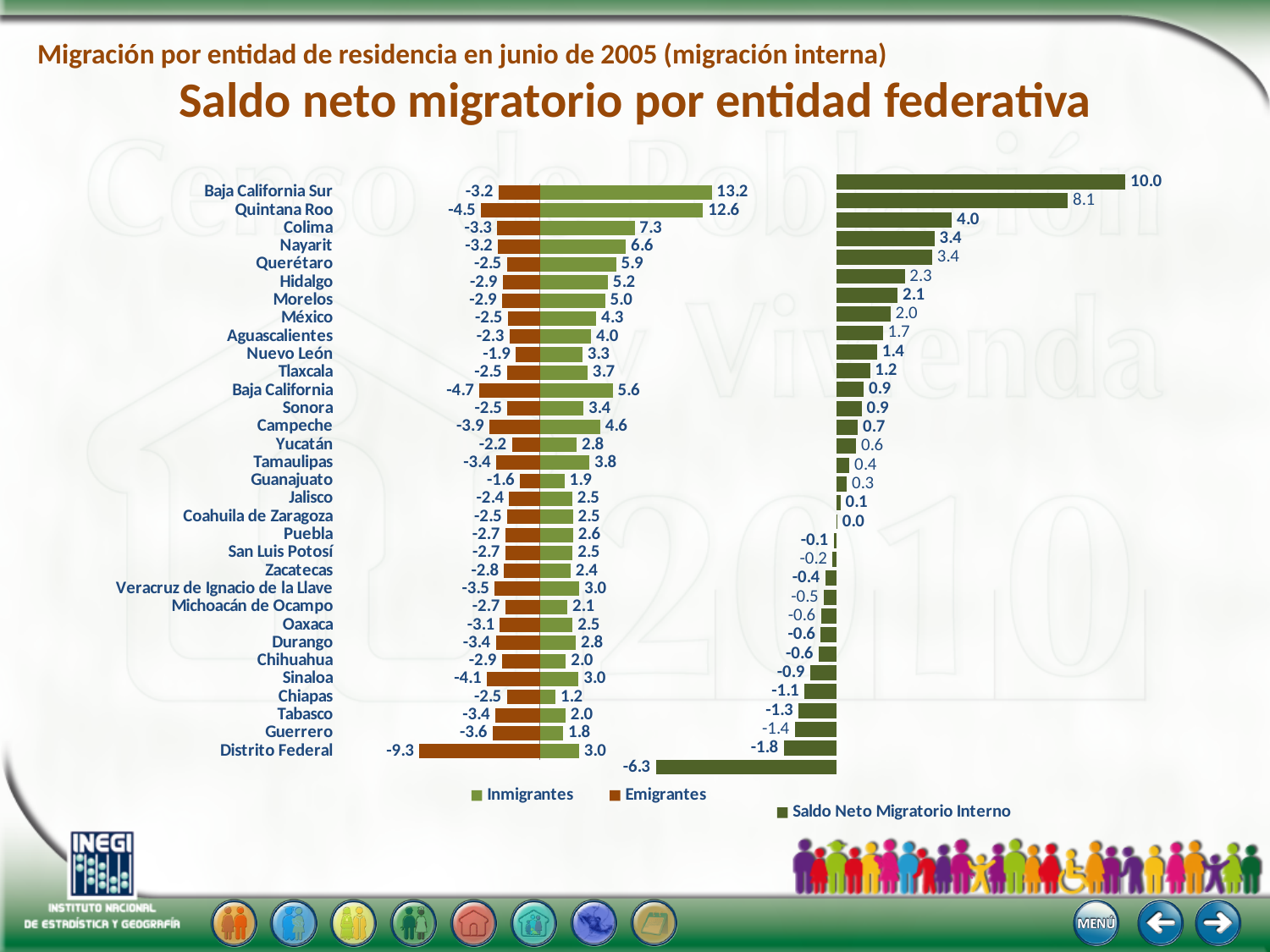
In the right chart (Saldo Neto Migratorio Interno), what is the lowest value shown? -6.3 In the left chart, which entity has the highest Inmigrantes value? Baja California Sur In the right chart, what is the Saldo Neto Migratorio Interno value for Quintana Roo? 8.1 In the left chart, which entity has the lowest (most negative) Emigrantes value? Distrito Federal In the right chart (Saldo Neto Migratorio Interno), which entity has the highest value? Baja California Sur In the left chart, what is the difference between the Inmigrantes values of Quintana Roo and Colima? 5.3 In the left chart, which has the larger Inmigrantes value, Nayarit or Querétaro? Nayarit How many entities (categories) are listed on the left chart? 32 In the left chart, what is the Inmigrantes value for Baja California Sur? 13.2 How many series does the legend of the left chart list? 2 In the left chart, what is the Emigrantes value for Distrito Federal? -9.3 What kind of chart is the left chart showing Inmigrantes and Emigrantes? bar chart